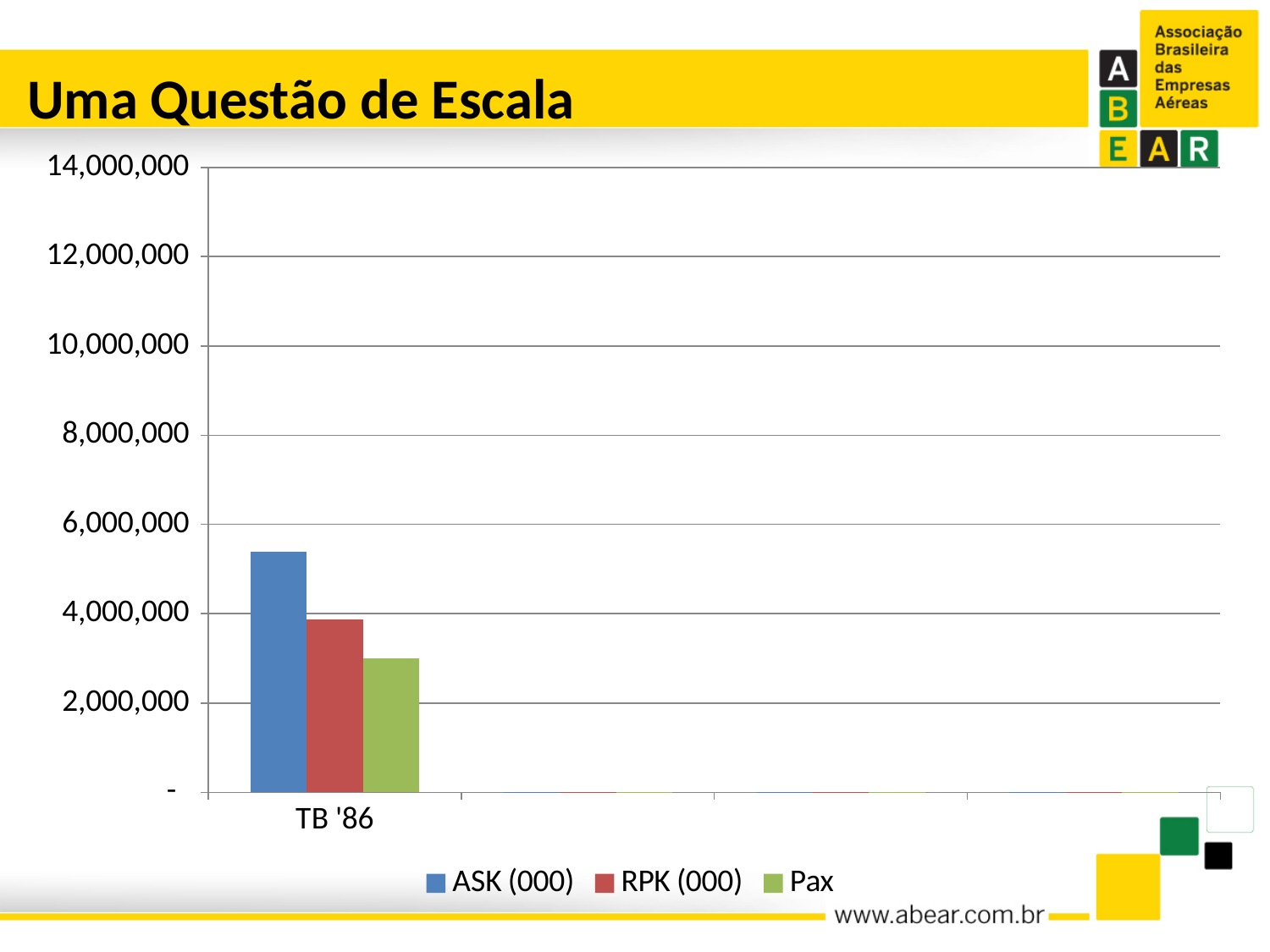
Which series has the shortest bar for TB '86? Pax How many series does the chart legend list? 3 For TB '86, which is larger: the RPK (000) value or the Pax value? RPK (000) What kind of chart is shown on the slide? bar chart For TB '86, is the value for ASK (000) greater or less than 6,000,000? less For TB '86, is the value for ASK (000) greater or less than 4,000,000? greater For TB '86, is the value for RPK (000) greater or less than 2,000,000? greater Which colour represents the Pax series in the chart? green Which series has the tallest bar for TB '86? ASK (000) What are the series names listed in the chart legend? ASK (000), RPK (000), Pax